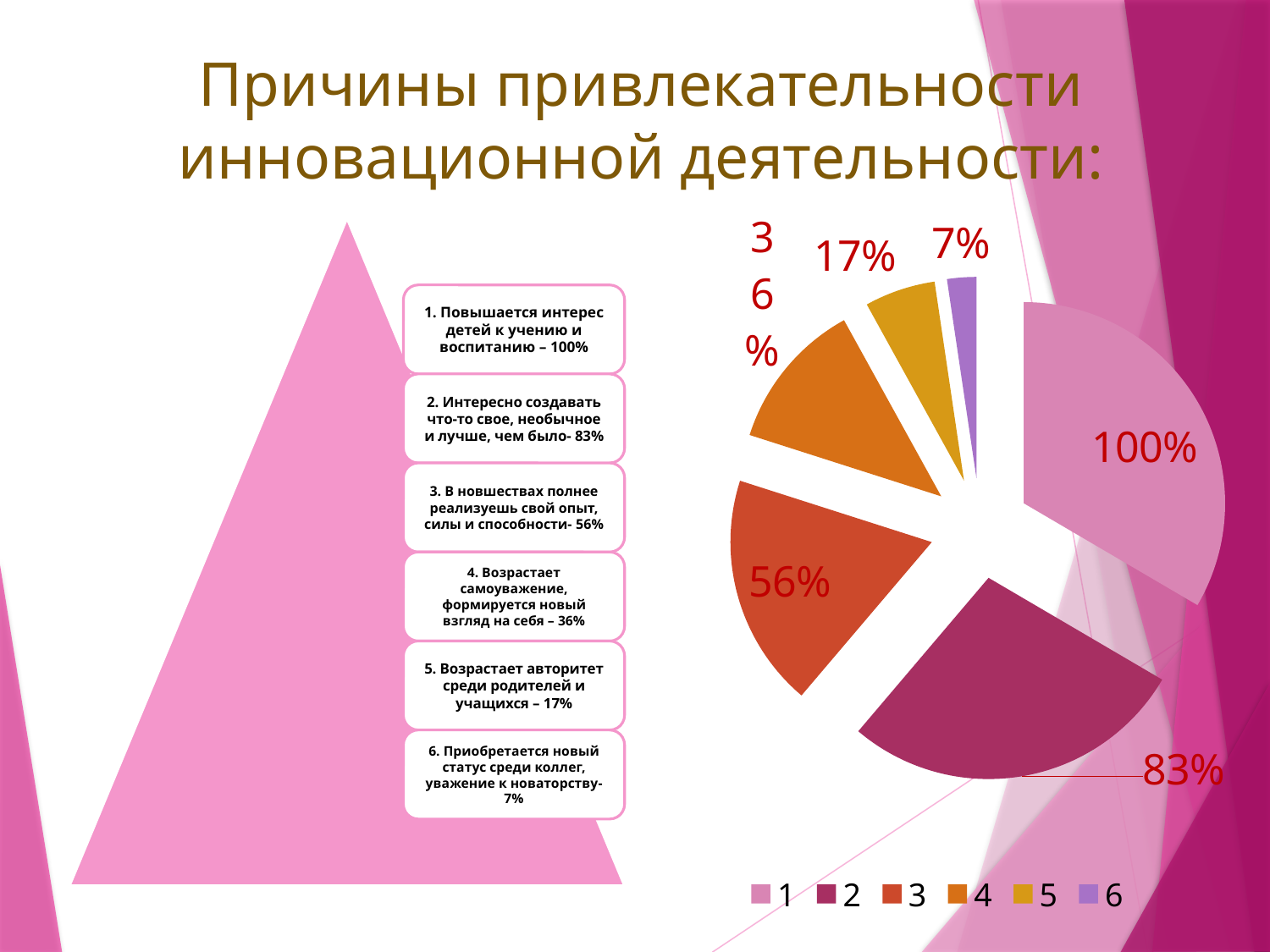
Which category has the largest slice in the pie chart? 1 What value is labelled on the slice for category 1 in the pie chart? 100% What value is labelled on the slice for category 6 in the pie chart? 7% How many slices does the pie chart have? 6 What value is labelled on the slice for category 2 in the pie chart? 83% What value is labelled on the slice for category 5 in the pie chart? 17% What kind of chart is shown on the slide? pie chart What value is labelled on the slice for category 3 in the pie chart? 56% How many entries does the legend of the pie chart list? 6 What is the difference between the labelled values for category 1 and category 2 in the pie chart? 17% Which is larger in the pie chart, the value for category 3 or the value for category 4? category 3 Which category has the smallest slice in the pie chart? 6